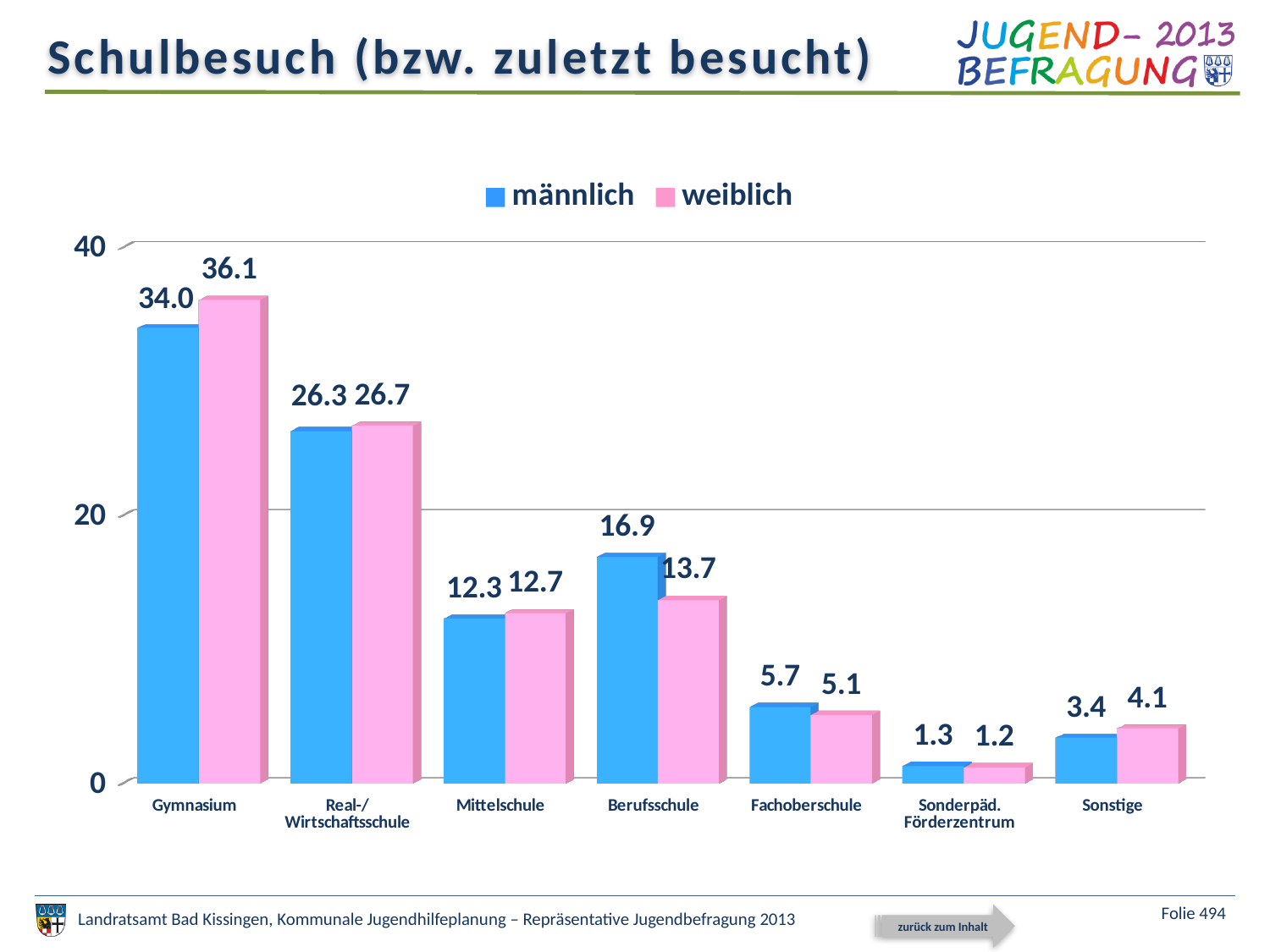
What is the value for männlich at Gymnasium? 34.0 What is the value for weiblich at Sonstige? 4.1 How many categories are shown on the x axis? 7 Which is larger at Fachoberschule, the männlich value or the weiblich value? männlich Is the männlich value for Real-/Wirtschaftsschule greater or less than 20? greater How many series does the legend list? 2 What kind of chart is shown on the slide? bar chart What is the value for weiblich at Berufsschule? 13.7 Which category has the lowest value for männlich? Sonderpäd. Förderzentrum What is the difference between the weiblich and männlich values at Gymnasium? 2.1 Which category has the highest value for weiblich? Gymnasium What is the difference between the männlich and weiblich values at Berufsschule? 3.2